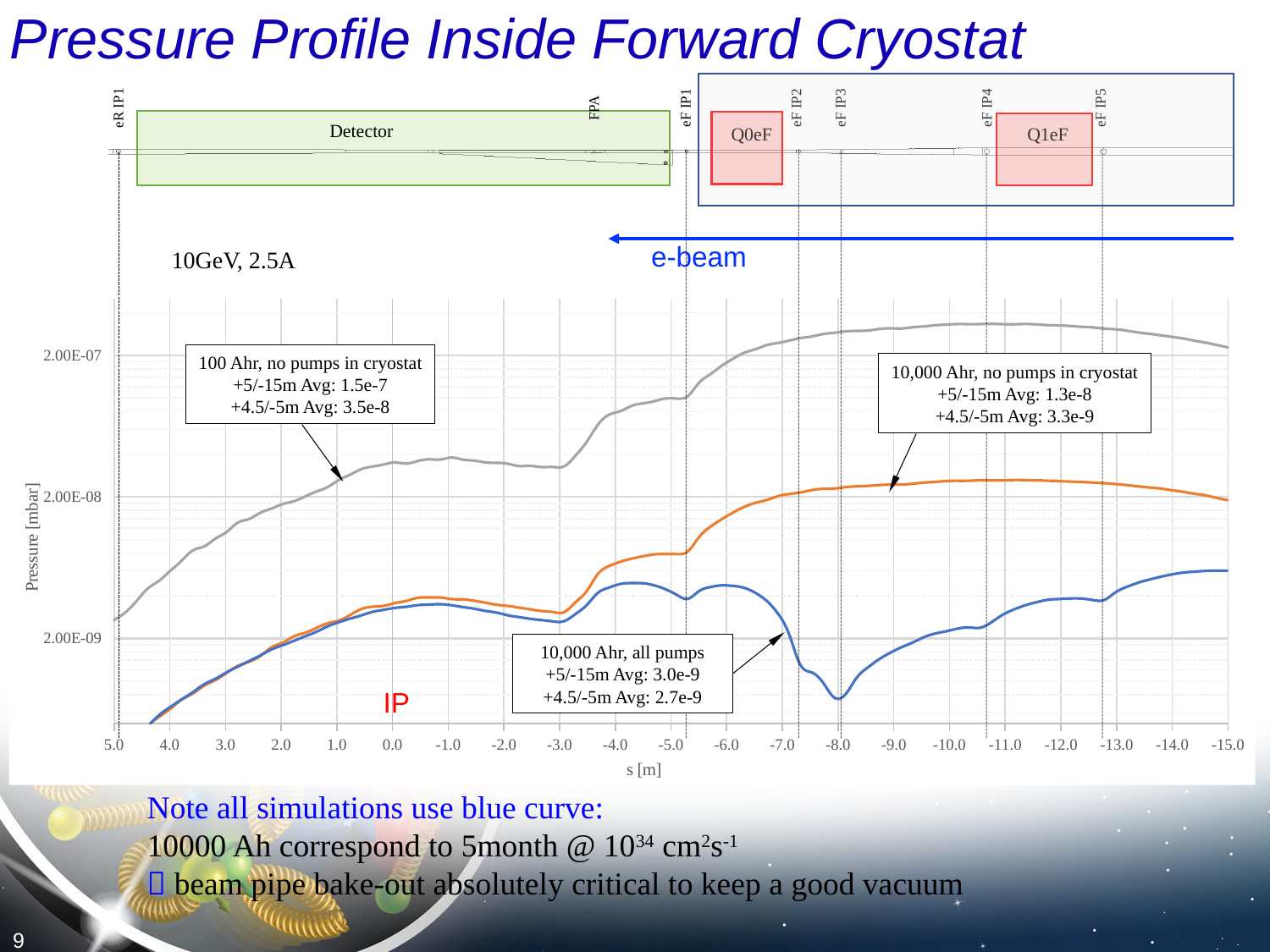
How many pressure curves are plotted on the chart? 3 What kind of chart is shown on the slide? line chart Which curve has the lowest +5/-15m average pressure? 10,000 Ahr, all pumps What is the +4.5/-5m average pressure for the '100 Ahr, no pumps in cryostat' curve? 3.5e-8 What is the +5/-15m average pressure for the '10,000 Ahr, no pumps in cryostat' curve? 1.3e-8 What is the label of the vertical axis of the chart? Pressure [mbar] Is the pressure of the '100 Ahr, no pumps in cryostat' curve at s = -10.0 m greater or less than 2.00E-07? greater Which curve has the highest pressure across the plotted range: '100 Ahr, no pumps in cryostat', '10,000 Ahr, no pumps in cryostat', or '10,000 Ahr, all pumps'? 100 Ahr, no pumps in cryostat What is the +5/-15m average pressure for the '100 Ahr, no pumps in cryostat' curve? 1.5e-7 What is the +4.5/-5m average pressure for the '10,000 Ahr, all pumps' curve? 2.7e-9 Which is larger, the +5/-15m average of the '10,000 Ahr, no pumps in cryostat' curve or the +5/-15m average of the '10,000 Ahr, all pumps' curve? 10,000 Ahr, no pumps in cryostat Is the pressure of the '10,000 Ahr, all pumps' curve at s = -8.0 m greater or less than 2.00E-09? less